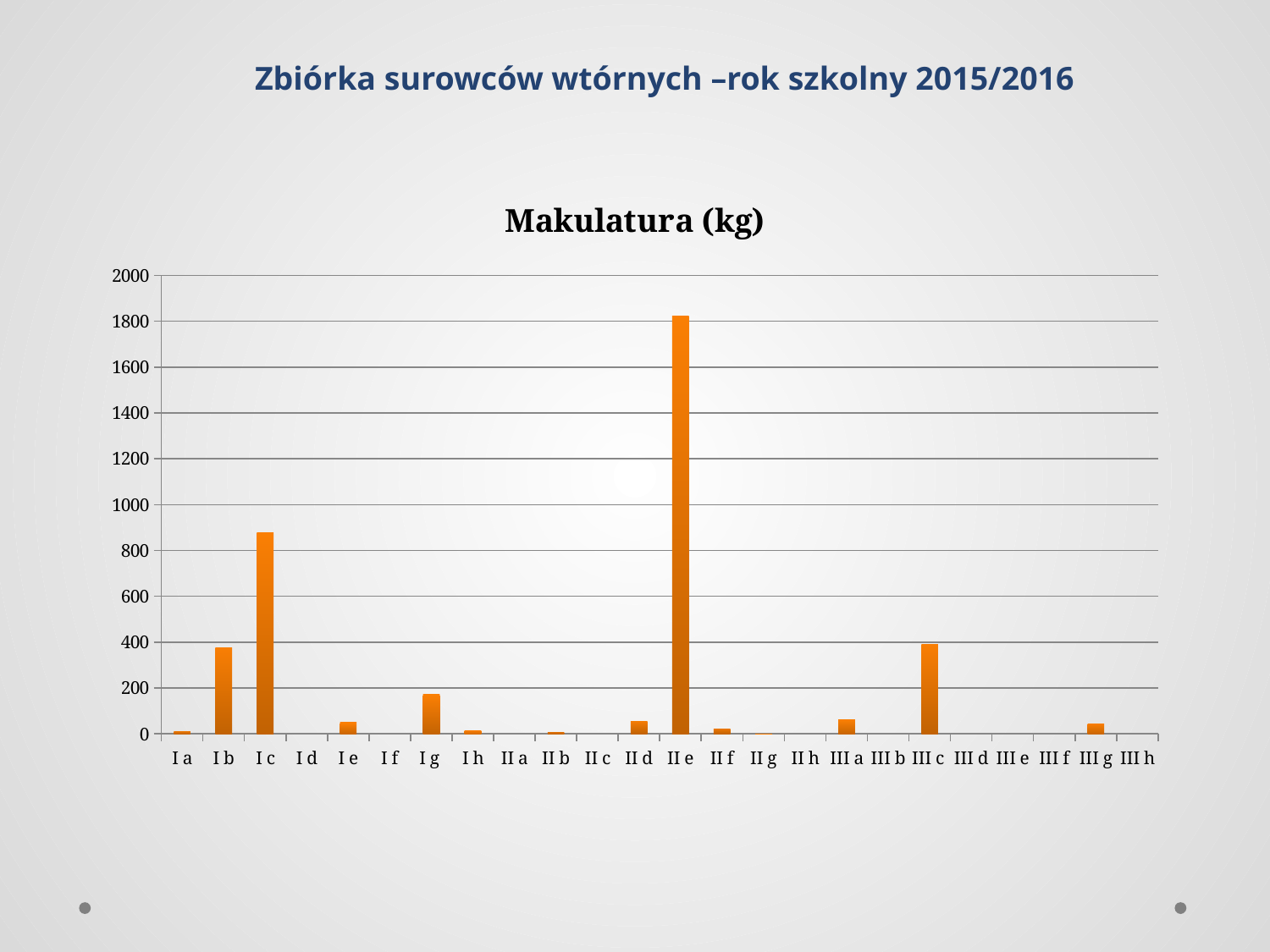
What kind of chart is shown on the slide? bar chart Is the value for I c greater or less than 1000? less What is the title of the chart? Makulatura (kg) Which is larger, the value for II e or the value for I b? II e Which is larger, the value for I g or the value for II d? I g Is the value for I c greater or less than 800? greater Which category has the highest value in the chart? II e How many categories are shown on the x axis of the chart? 24 Is the value for I b greater or less than 400? less Which is larger, the value for I c or the value for III c? I c